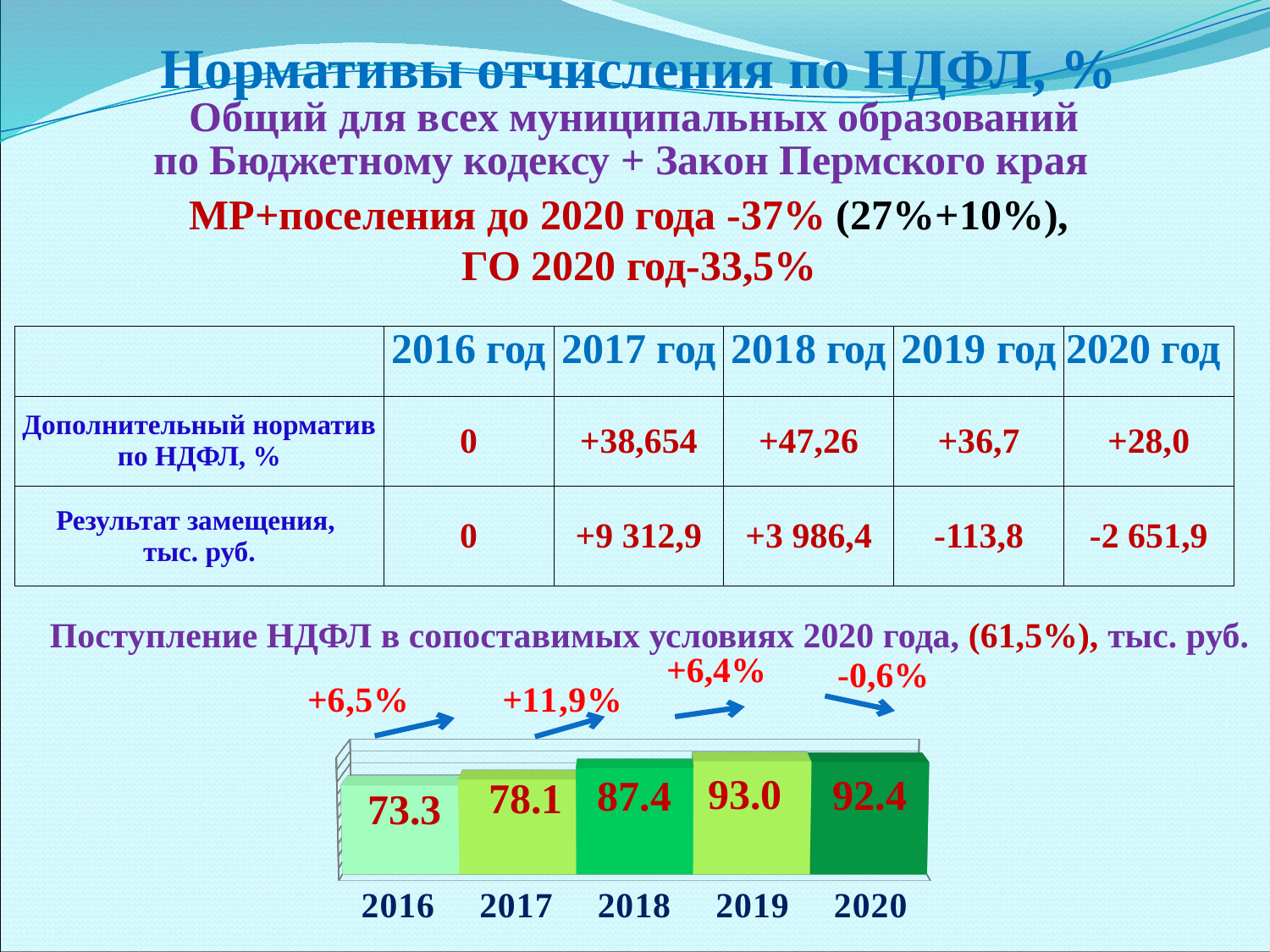
Which year has the lowest bar in the chart? 2016 Which is larger in the chart, the value for 2017 or the value for 2018? 2018 How many bars are shown in the chart? 5 Which year has the highest bar in the chart? 2019 What is the value of the bar for 2018 in the chart? 87.4 What is the value of the bar for 2016 in the chart? 73.3 What is the value of the bar for 2020 in the chart? 92.4 What kind of chart is shown at the bottom of the slide? bar chart What is the difference between the values for 2019 and 2020 in the chart? 0.6 What percentage change is annotated above the 2020 bar in the chart? -0,6% What is the difference between the values for 2018 and 2017 in the chart? 9.3 Do the bar values rise or fall from 2016 to 2019 in the chart? rise